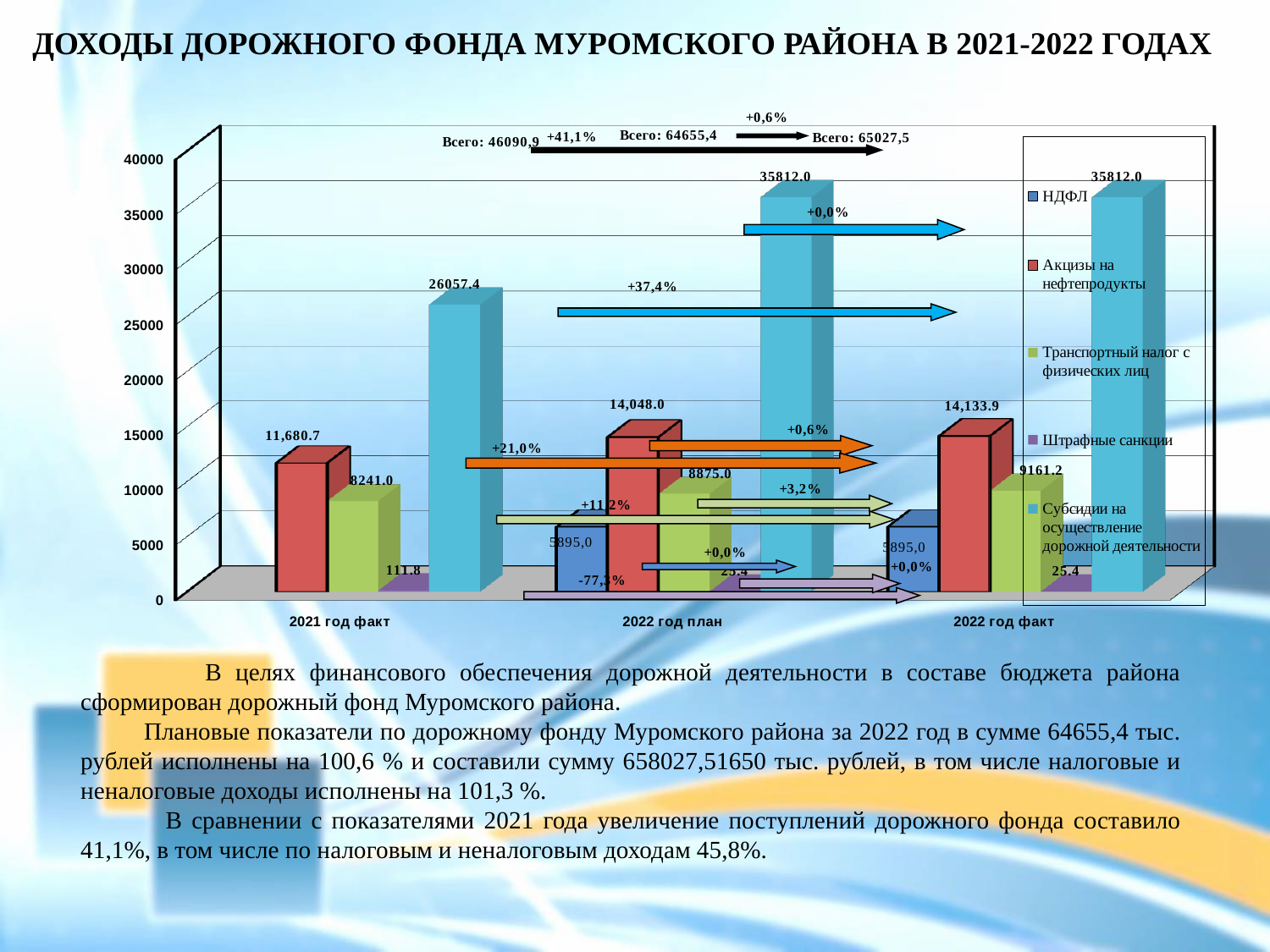
How many series does the legend list? 5 What total (Всего) is shown for 2021 год факт? 46090,9 How many categories are shown on the x axis? 3 Is the value of Субсидии на осуществление дорожной деятельности for 2022 год факт greater or less than 30000? greater Which is larger for Акцизы на нефтепродукты: 2022 год план or 2022 год факт? 2022 год факт What is the value of Акцизы на нефтепродукты for 2022 год факт? 14,133.9 What is the value of Субсидии на осуществление дорожной деятельности for 2021 год факт? 26057.4 What kind of chart is shown on the slide? bar chart What is the value of Штрафные санкции for 2021 год факт? 111.8 What is the difference between Транспортный налог с физических лиц for 2022 год факт and 2022 год план? 286.2 Which series has the highest value in 2021 год факт? Субсидии на осуществление дорожной деятельности What is the value of Транспортный налог с физических лиц for 2022 год план? 8875.0